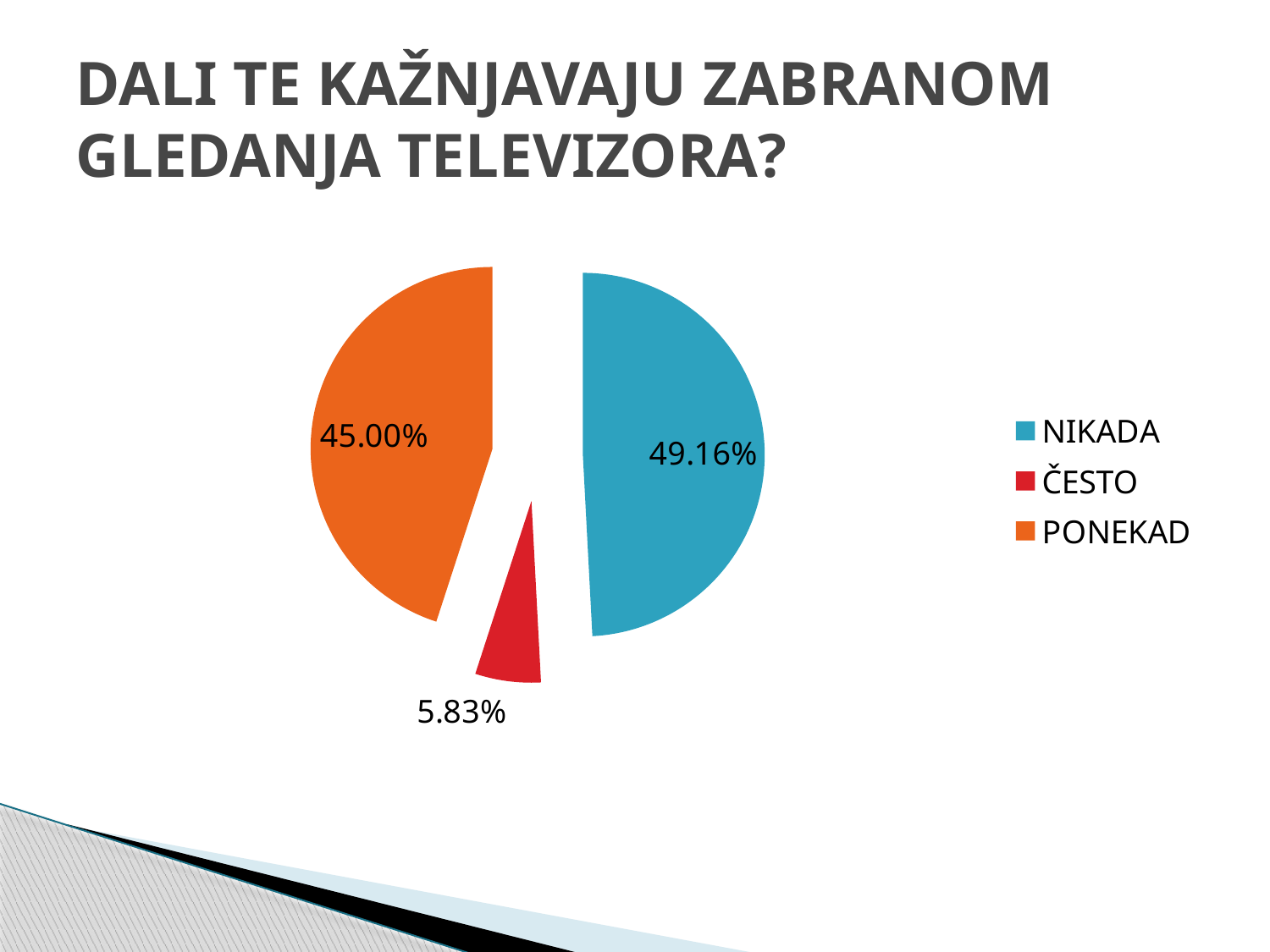
What kind of chart is shown on the slide? pie chart Which category has the smallest slice of the pie? ČESTO What percentage of the pie is labelled NIKADA? 49.16% How many entries does the legend list? 3 Which category has the largest slice of the pie? NIKADA What percentage of the pie is labelled ČESTO? 5.83% What is the difference in percentage points between the PONEKAD and ČESTO slices? 39.17 What is the difference in percentage points between the NIKADA and PONEKAD slices? 4.16 What colour is the ČESTO slice? red How many slices does the pie chart have? 3 Which slice is larger, NIKADA or PONEKAD? NIKADA What percentage of the pie is labelled PONEKAD? 45.00%